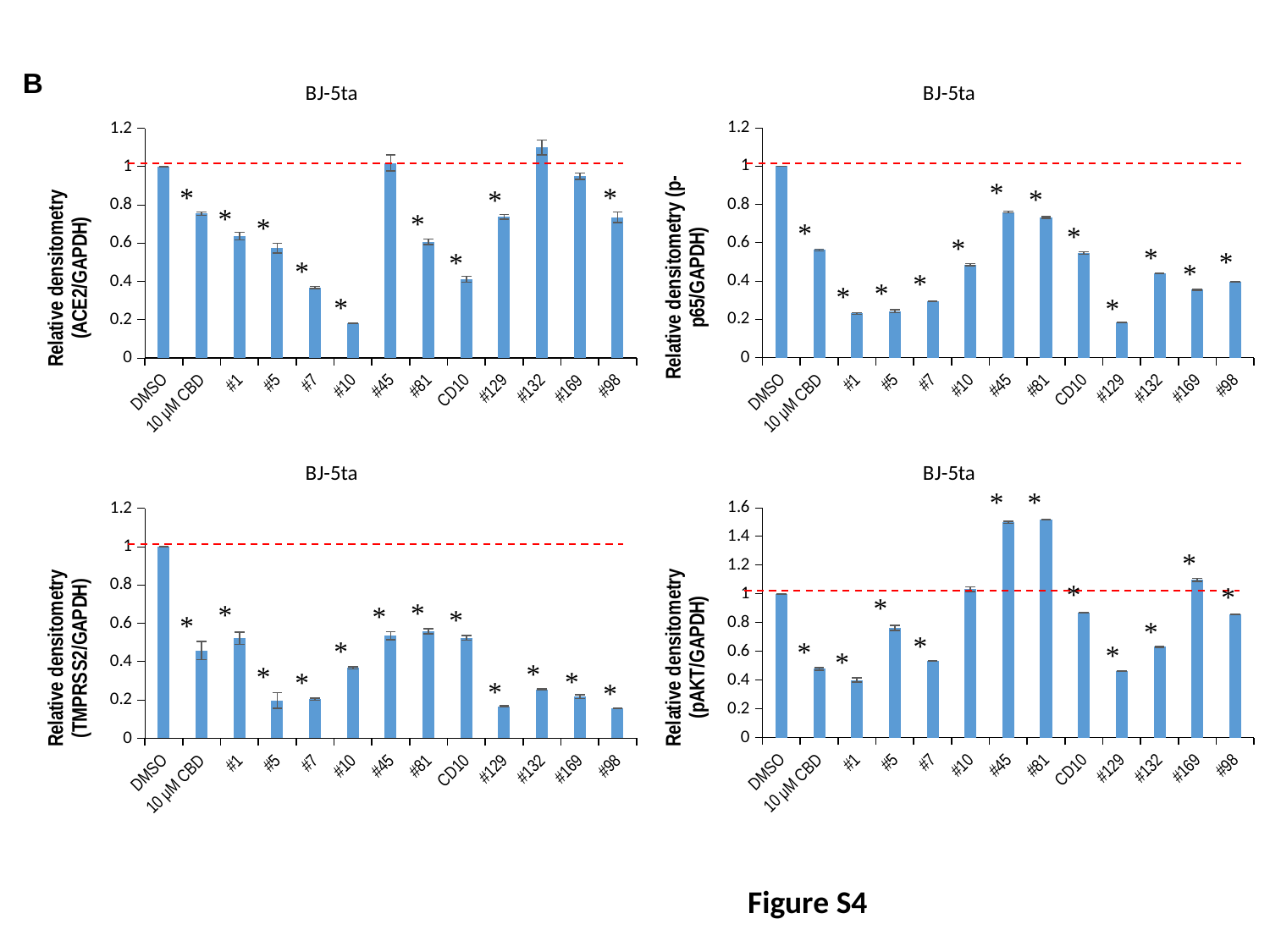
In the top-right chart (p-p65/GAPDH), is the value for #45 greater or less than 0.6? greater In the bottom-right chart (pAKT/GAPDH), is the value for #45 greater or less than 1.2? greater In the bottom-left chart (TMPRSS2/GAPDH), is the value for #5 greater or less than 0.4? less What kind of chart is the top-left chart (Relative densitometry ACE2/GAPDH)? bar chart How many categories are shown on the x axis of the top-left chart (ACE2/GAPDH)? 13 In the top-left chart (ACE2/GAPDH), which is larger, the value for #45 or the value for #7? #45 In the top-right chart (p-p65/GAPDH), which category has the highest value? DMSO In the top-left chart (ACE2/GAPDH), which category has the lowest value? #10 What is the title shown above each of the four charts on the slide? BJ-5ta In the top-left chart (ACE2/GAPDH), which category has the highest value? #132